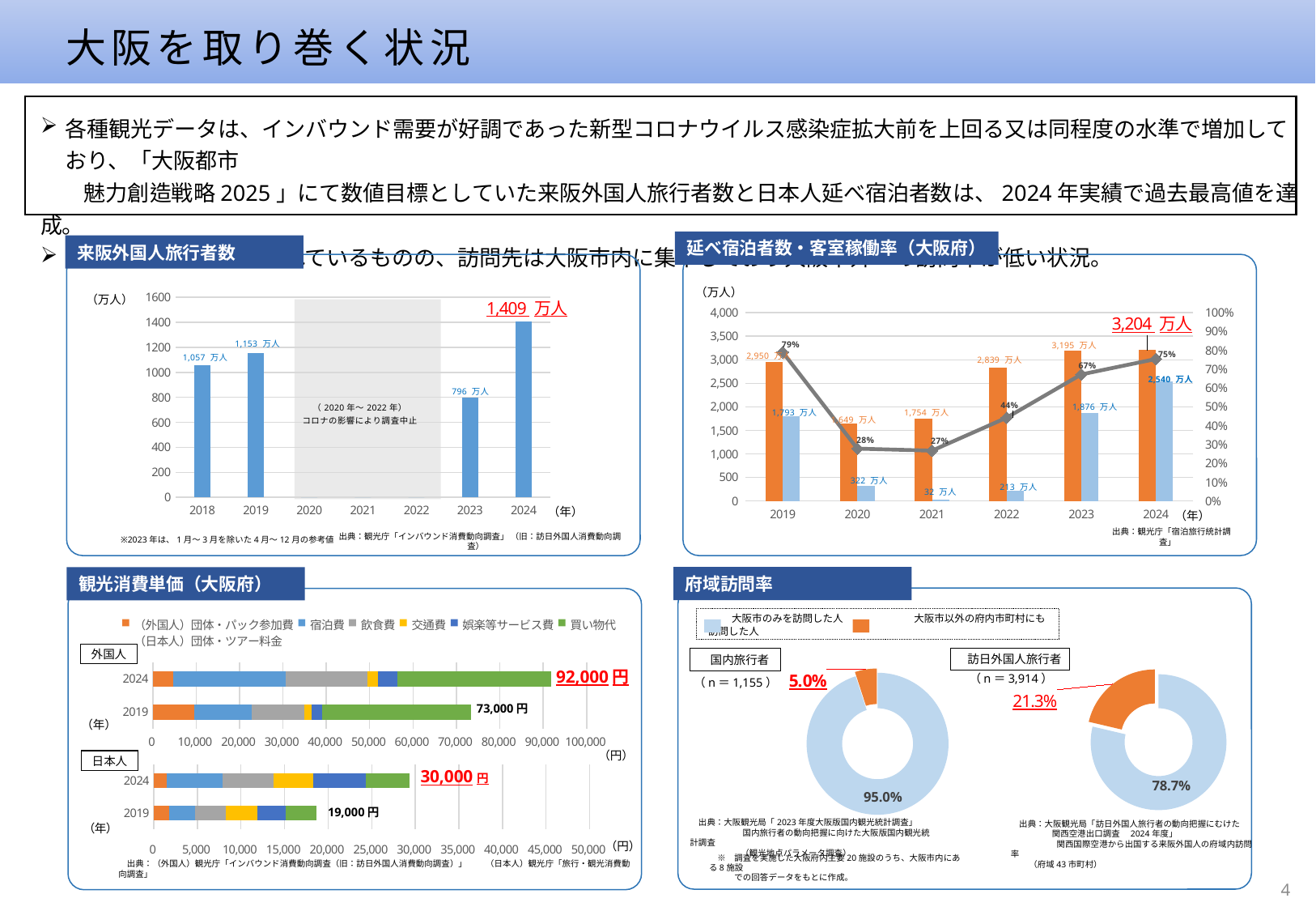
In the 延べ宿泊者数・客室稼働率（大阪府） chart, what is the occupancy rate (line) for 2021? 27% In the 観光消費単価（大阪府） chart, how many series does the legend list? 6 In the 来阪外国人旅行者数 chart, how many years have a bar plotted? 4 In the 観光消費単価（大阪府） chart, what is the difference between the 日本人 totals for 2024 and 2019? 11,000 円 In the 来阪外国人旅行者数 chart, which year has the lowest value among the plotted bars? 2023 In the 延べ宿泊者数・客室稼働率（大阪府） chart, which year has the lowest light-blue bar? 2021 In the 延べ宿泊者数・客室稼働率（大阪府） chart, is the orange bar for 2019 larger or the orange bar for 2022? 2019 In the 来阪外国人旅行者数 chart, what is the difference between the 2024 value and the 2019 value? 256 万人 In the 延べ宿泊者数・客室稼働率（大阪府） chart, what is the value of the orange bar for 2024? 3,204 万人 In the 来阪外国人旅行者数 chart, what is the value for 2024? 1,409 万人 In the 府域訪問率 chart, what share of 訪日外国人旅行者 visited municipalities outside Osaka City? 21.3% In the 観光消費単価（大阪府） chart, what is the total for 外国人 in 2024? 92,000 円